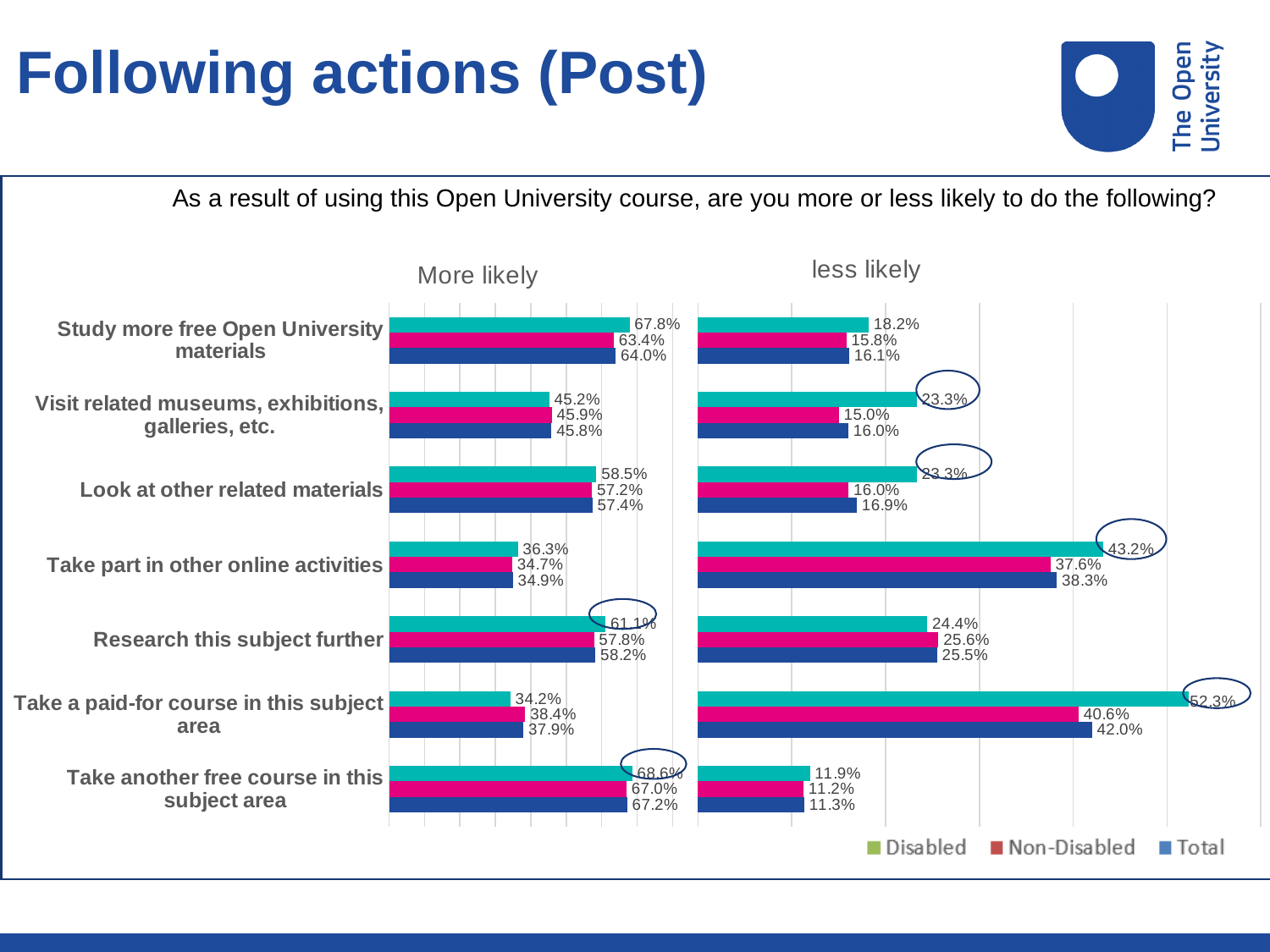
What are the three series listed in the legend? Disabled, Non-Disabled, Total In the 'More likely' chart, what is the Non-Disabled value for 'Research this subject further'? 57.8% In the 'less likely' chart, what is the Total value for 'Take a paid-for course in this subject area'? 42.0% In the 'less likely' chart, what is the difference between the Disabled and Non-Disabled values for 'Take a paid-for course in this subject area'? 11.7% In the 'More likely' chart, which category has the lowest Total value? Take part in other online activities In the 'More likely' chart, which is larger for 'Take a paid-for course in this subject area': the Disabled value or the Non-Disabled value? Non-Disabled In the 'less likely' chart, which category has the highest Disabled value? Take a paid-for course in this subject area What kind of chart is the 'less likely' chart? Bar chart How many categories are shown in the 'More likely' chart? 7 In the 'More likely' chart, what is the Disabled value for 'Study more free Open University materials'? 67.8% How many series does the legend list? 3 In the 'less likely' chart, what is the Total value for 'Take another free course in this subject area'? 11.3%